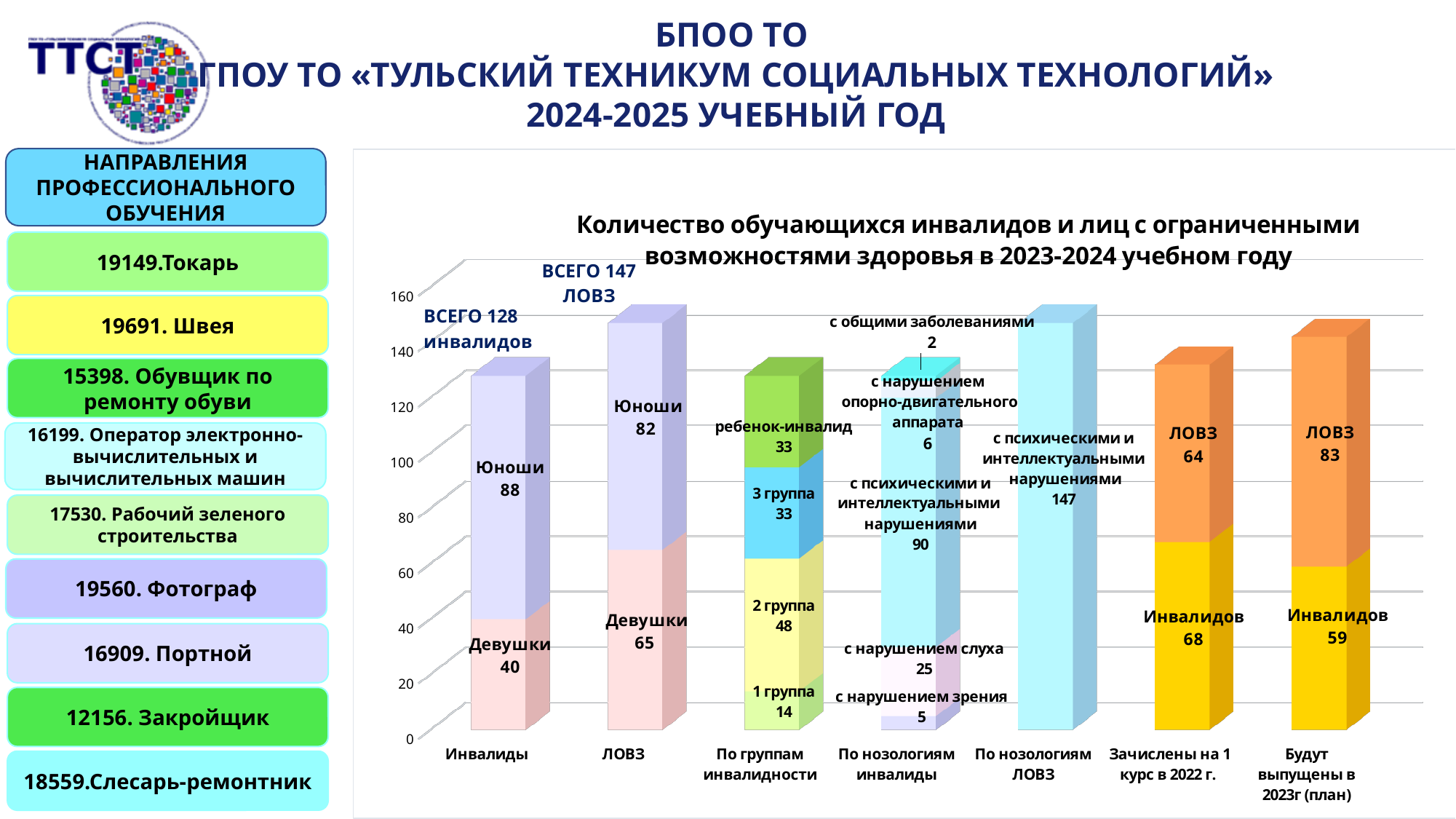
What is the value for ЛОВЗ in the Будут выпущены в 2023г (план) bar? 83 Which segment is the smallest in the По нозологиям инвалиды bar? с общими заболеваниями How many categories are shown along the x axis of the chart? 7 What type of chart is shown on the slide? stacked bar chart Which is larger in the Будут выпущены в 2023г (план) bar: ЛОВЗ or Инвалидов? ЛОВЗ What is the total of the Зачислены на 1 курс в 2022 г. bar (ЛОВЗ plus Инвалидов)? 132 What is the difference between Юноши and Девушки in the Инвалиды bar? 48 What is the value for 2 группа in the По группам инвалидности bar? 48 What is the value for Юноши in the Инвалиды bar? 88 What is the value for Девушки in the ЛОВЗ bar? 65 What is the value for с нарушением слуха in the По нозологиям инвалиды bar? 25 What is the title of the chart? Количество обучающихся инвалидов и лиц с ограниченными возможностями здоровья в 2023-2024 учебном году